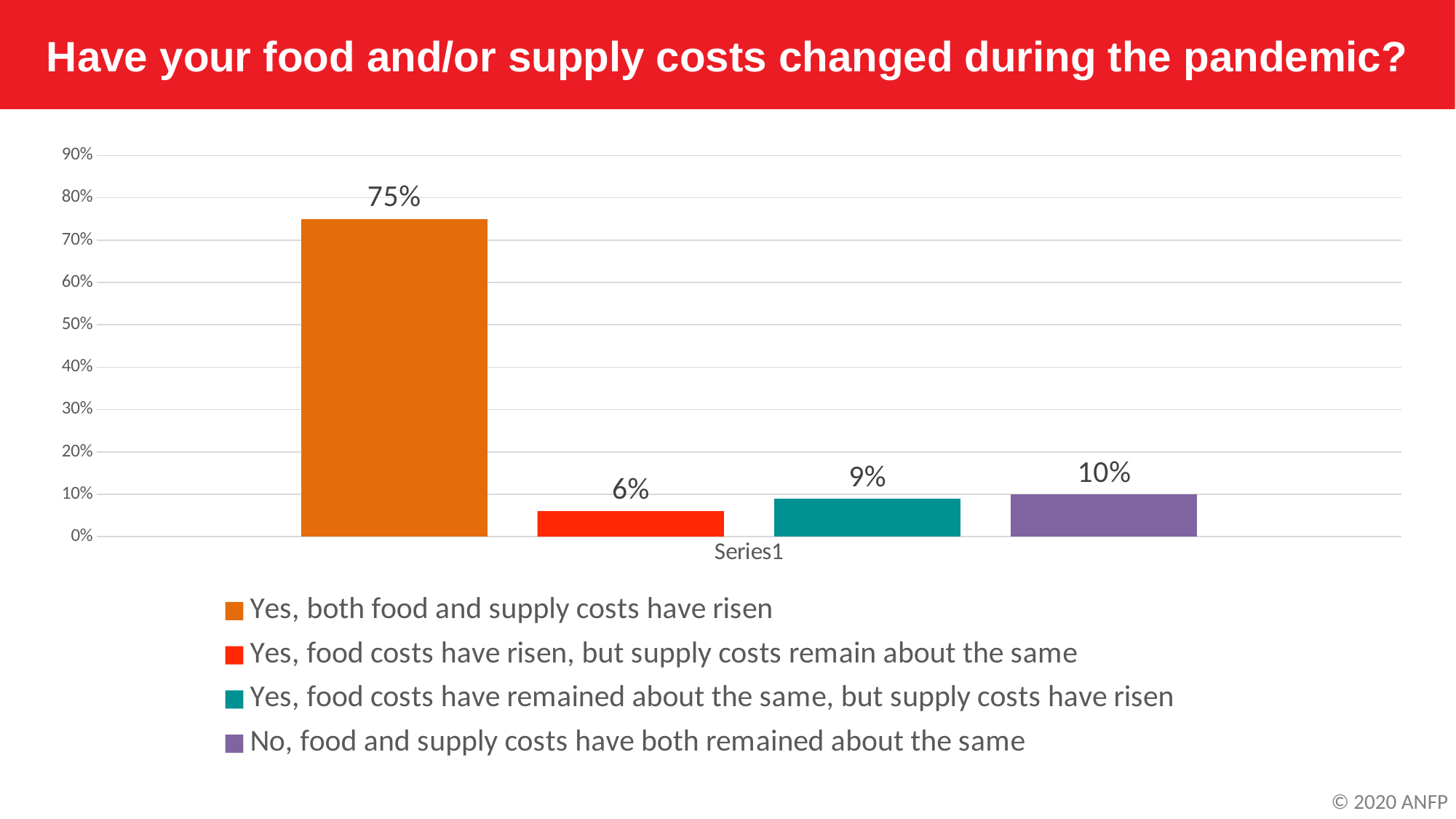
How many response categories are shown in the chart? 4 What type of chart is shown on the slide? Bar chart Which response has the lowest percentage? Yes, food costs have risen, but supply costs remain about the same What percentage of respondents said food and supply costs have both remained about the same? 10% What percentage of respondents said food costs have remained about the same but supply costs have risen? 9% What percentage of respondents said food costs have risen but supply costs remain about the same? 6% Which is larger: the percentage for 'Yes, food costs have remained about the same, but supply costs have risen' or for 'Yes, food costs have risen, but supply costs remain about the same'? Yes, food costs have remained about the same, but supply costs have risen What colour is the bar for 'No, food and supply costs have both remained about the same'? Purple What is the difference in percentage points between 'Yes, both food and supply costs have risen' and 'No, food and supply costs have both remained about the same'? 65 percentage points What is the title of the slide? Have your food and/or supply costs changed during the pandemic? What percentage of respondents said both food and supply costs have risen? 75% Which response has the highest percentage? Yes, both food and supply costs have risen